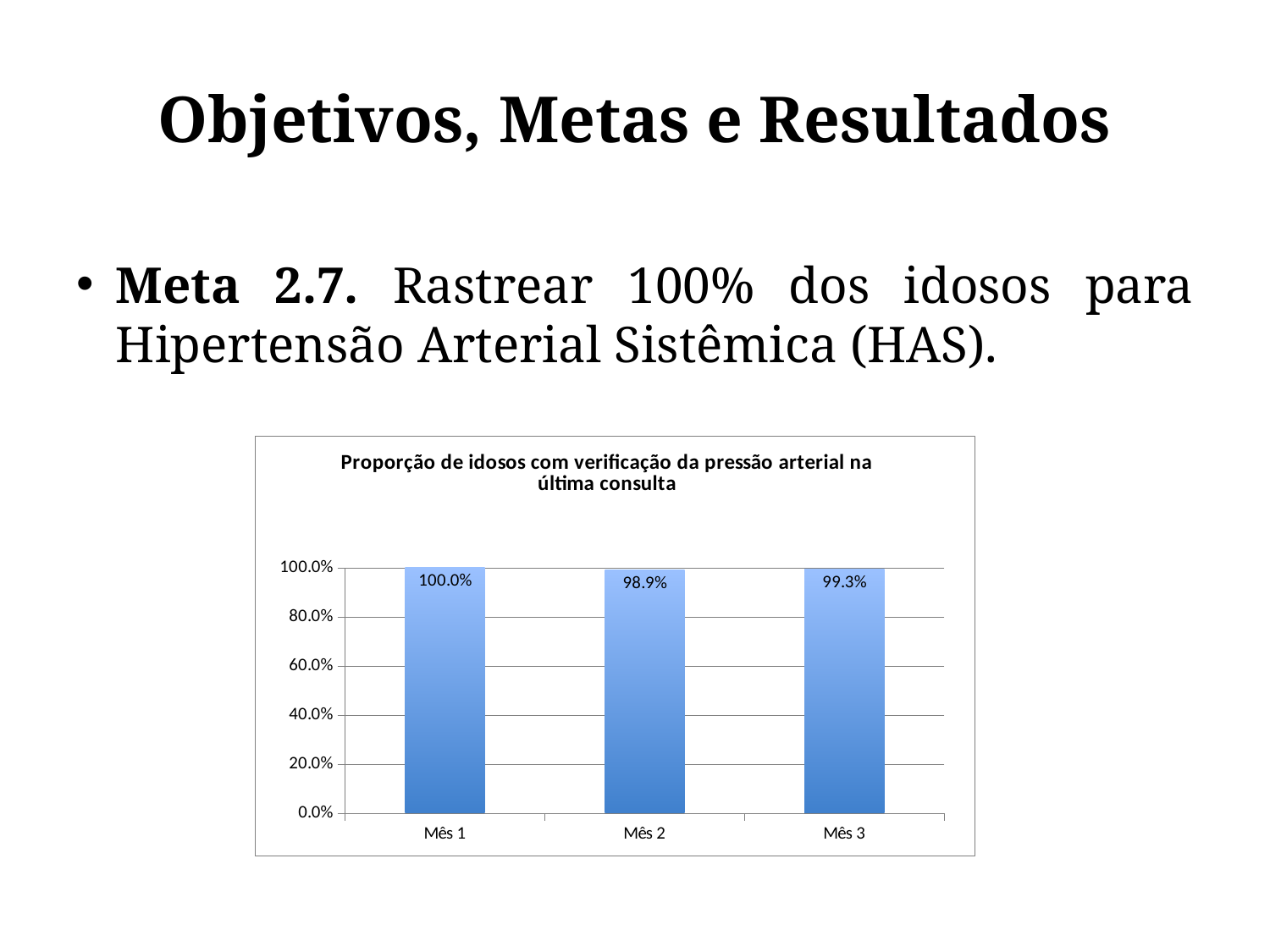
What kind of chart is shown on the slide? Bar chart What is the difference between the values for Mês 3 and Mês 2? 0.4% Is the value for Mês 2 greater or less than 80.0%? greater How many months are shown on the chart? 3 Which month has the highest value? Mês 1 What is the value for Mês 1? 100.0% What is the value for Mês 3? 99.3% What is the title of the chart? Proporção de idosos com verificação da pressão arterial na última consulta Which is larger, the value for Mês 2 or the value for Mês 3? Mês 3 What is the difference between the values for Mês 1 and Mês 2? 1.1% What is the value for Mês 2? 98.9% Which month has the lowest value? Mês 2